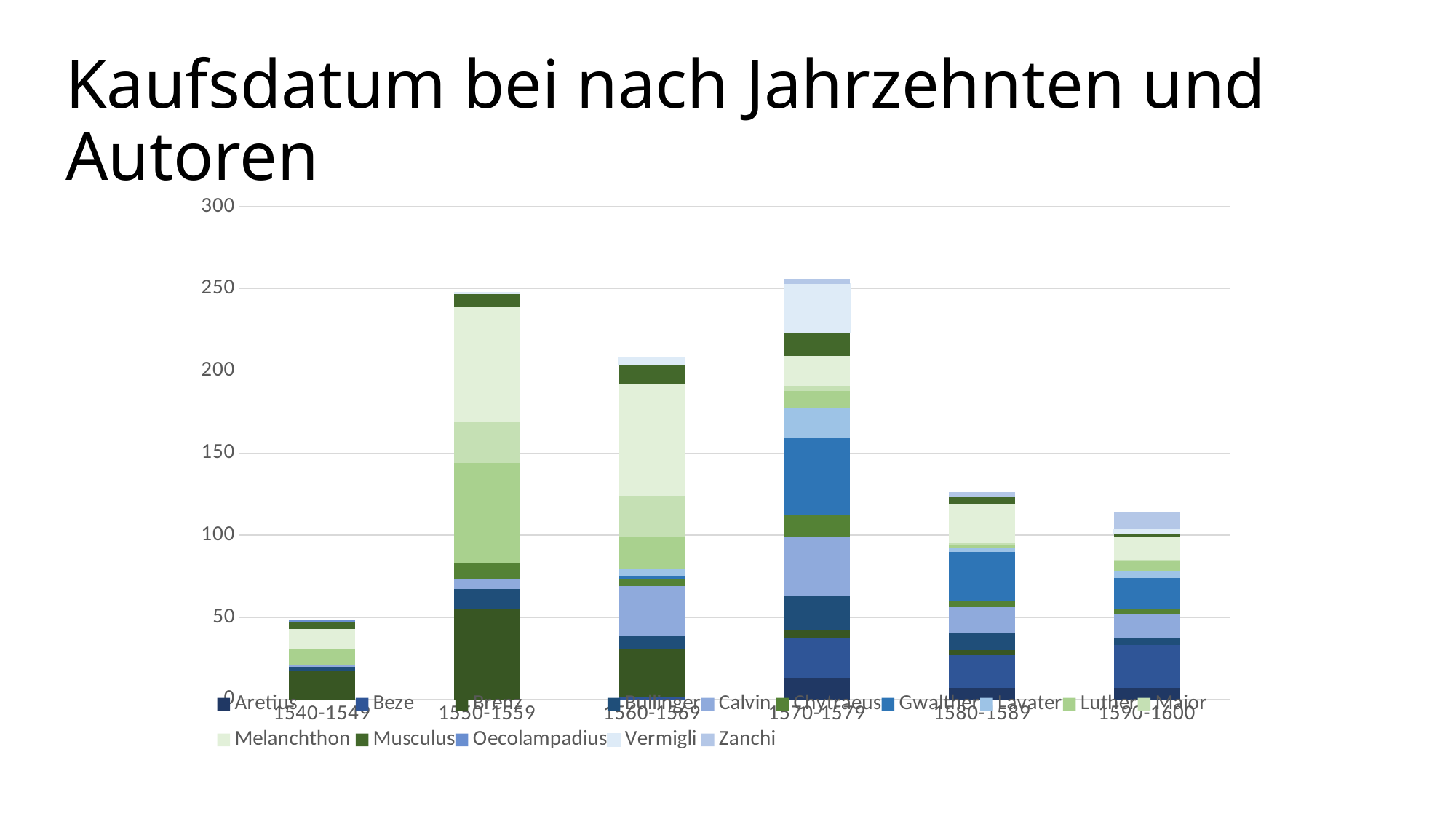
Is the total for 1550-1559 greater or less than 200? greater Which decade has the lowest total stacked bar? 1540-1549 How many series (authors) does the legend list? 15 How many decade categories are shown on the x axis? 6 What kind of chart is shown on the slide? Stacked bar chart Which decade has the larger total bar, 1560-1569 or 1580-1589? 1560-1569 Is the total for 1570-1579 greater or less than 200? greater Is the total for 1590-1600 greater or less than 100? greater Which decade has the larger total bar, 1580-1589 or 1590-1600? 1580-1589 What is the title of the chart? Kaufsdatum bei nach Jahrzehnten und Autoren